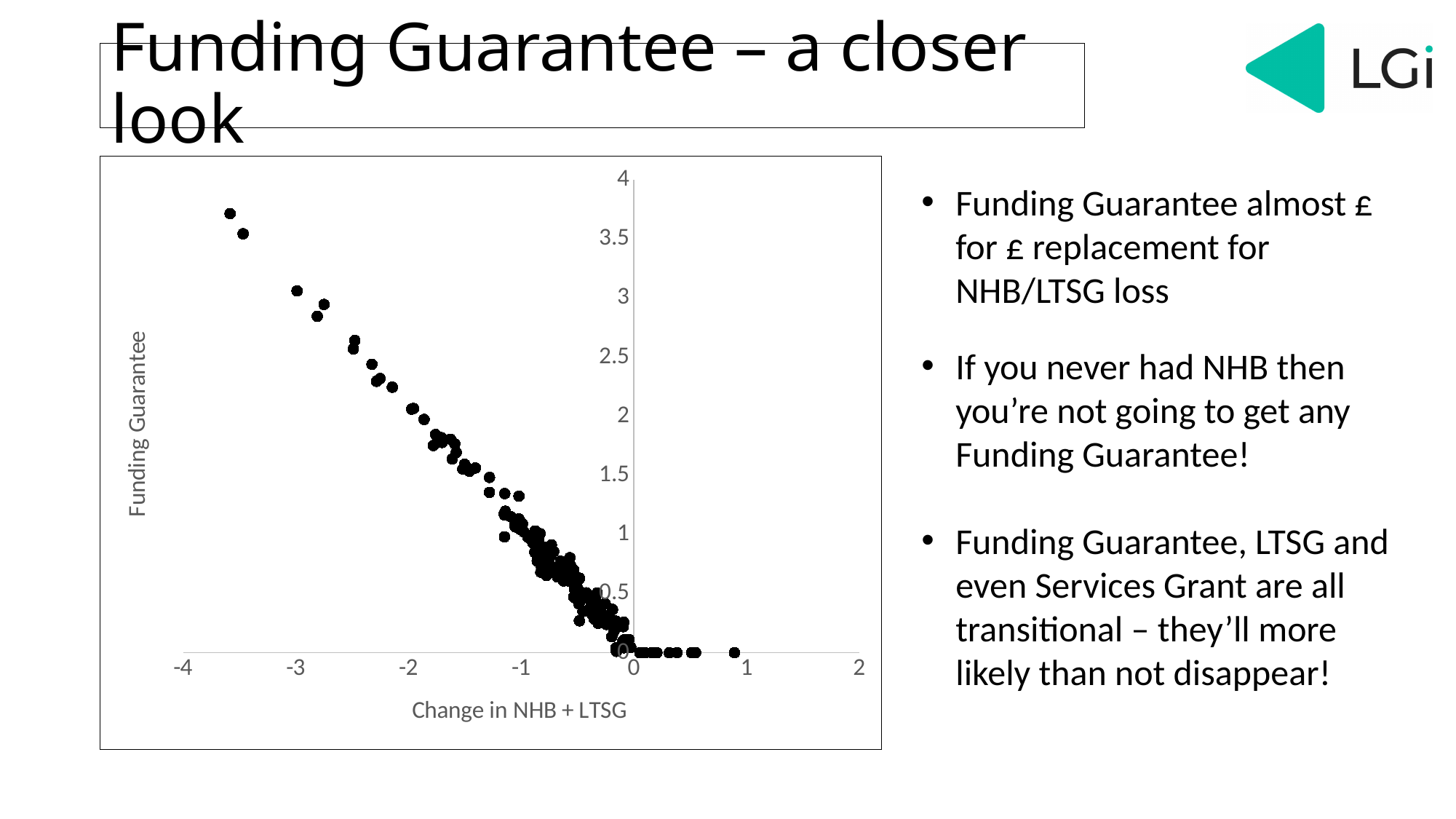
Is the Funding Guarantee for the point with the largest positive Change in NHB + LTSG greater or less than 0.5? less Is the lowest Change in NHB + LTSG value plotted greater or less than -3? less What is the label of the x axis of the chart? Change in NHB + LTSG Is the highest Funding Guarantee value plotted greater or less than 3.5? greater What kind of chart is shown on the slide? scatter chart What is the label of the y axis of the chart? Funding Guarantee As Change in NHB + LTSG increases along the x axis, does Funding Guarantee rise or fall? fall